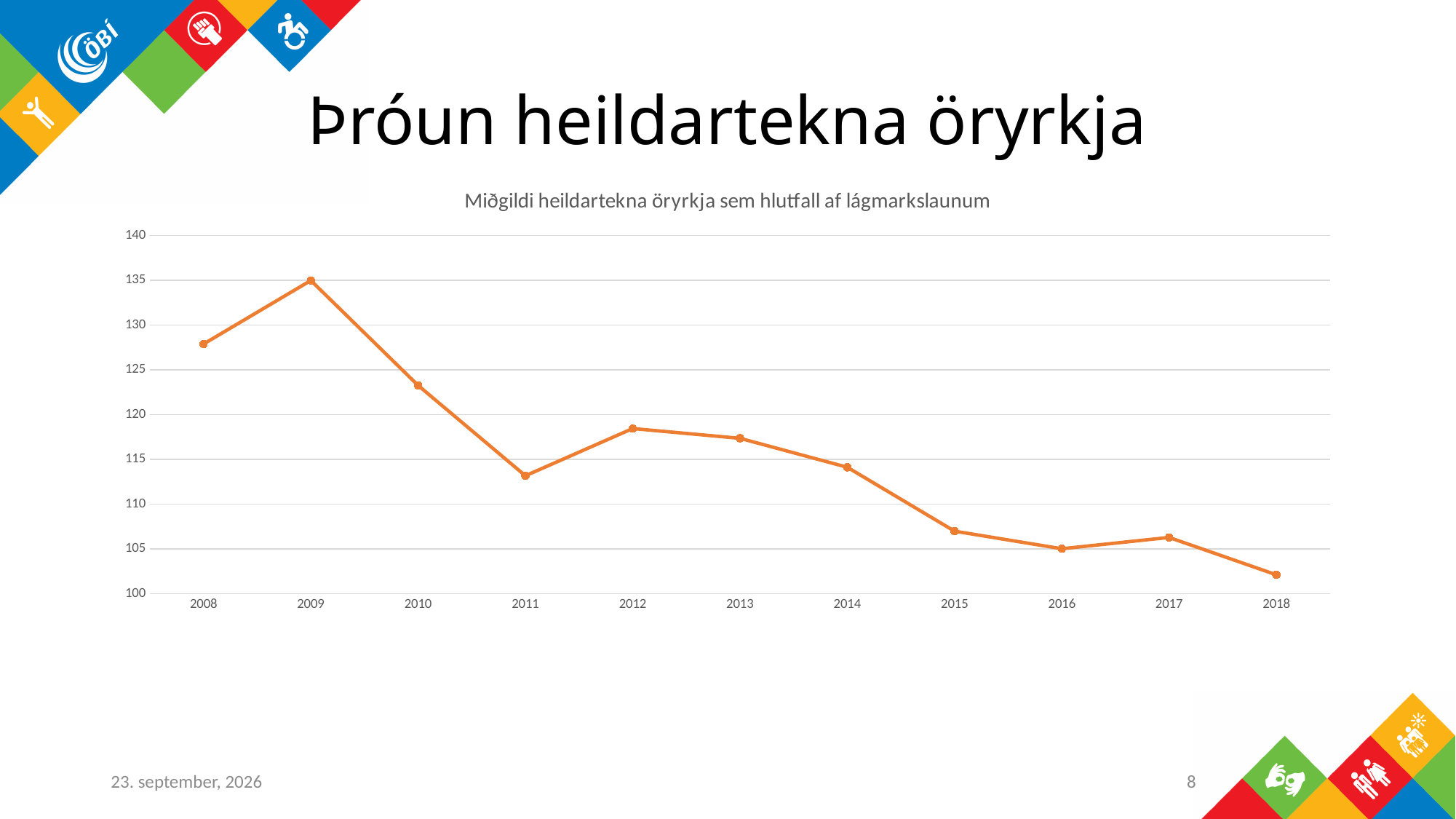
Is the value for 2018 greater or less than 105? less Which year has the larger value, 2010 or 2011? 2010 How many years are plotted on the x axis? 11 Do the values generally rise or fall from 2009 to 2018? fall Which year has the highest value? 2009 Which year has the lowest value? 2018 Is the value for 2011 greater or less than 115? less What is the title of the chart? Miðgildi heildartekna öryrkja sem hlutfall af lágmarkslaunum Is the value for 2008 greater or less than 125? greater What kind of chart is shown on the slide? line chart